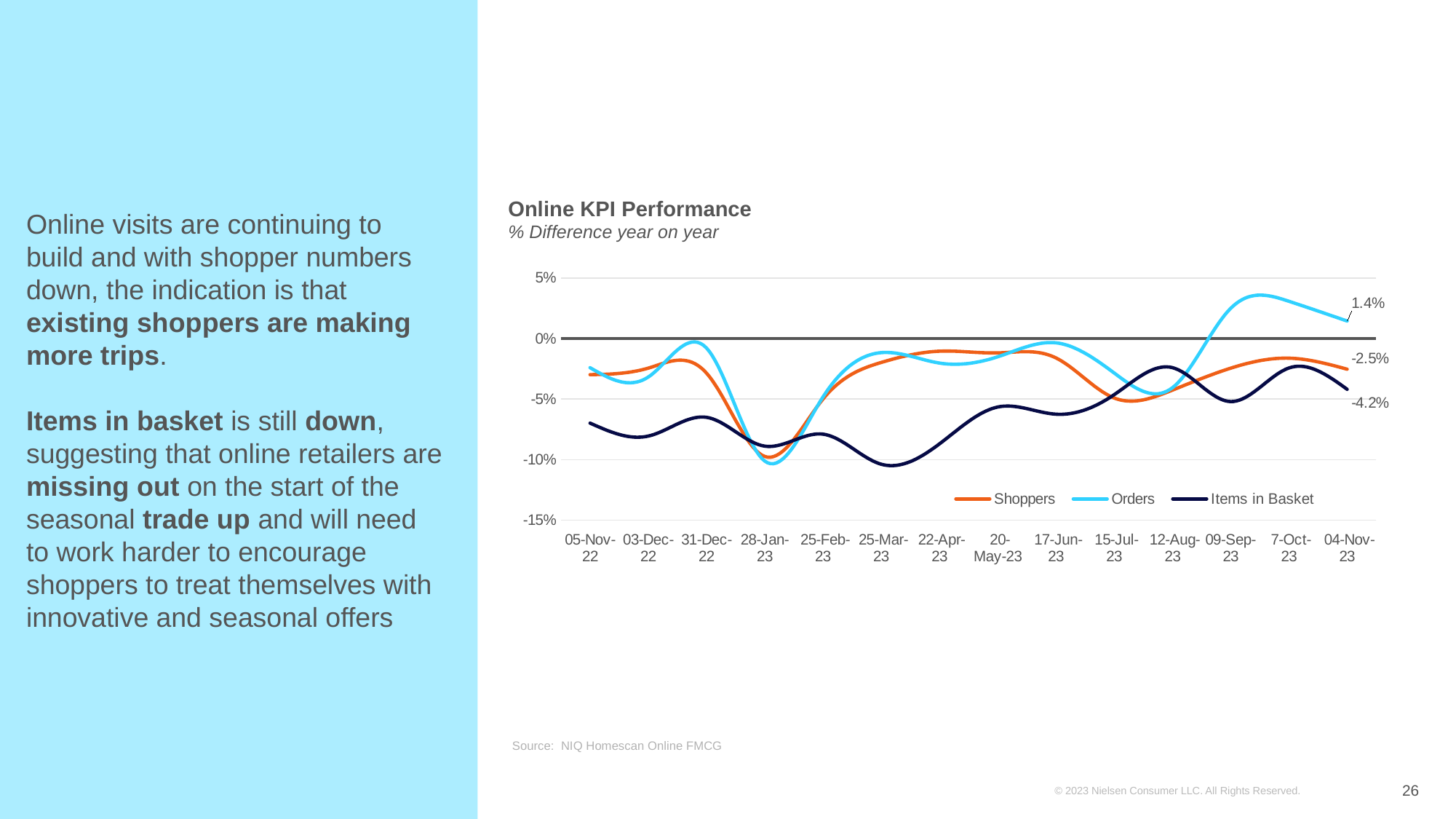
Is the value for Orders at 09-Sep-23 greater or less than 0%? greater How many series does the legend of the Online KPI Performance chart list? 3 Which series has the lowest value at 04-Nov-23? Items in Basket What is the value for Items in Basket at 04-Nov-23? -4.2% How many dates are shown on the x axis of the Online KPI Performance chart? 14 Which series has the highest value at 04-Nov-23? Orders What is the difference between the Orders value and the Items in Basket value at 04-Nov-23? 5.6 percentage points Is the value for Items in Basket at 05-Nov-22 greater or less than -5%? less What is the value for Shoppers at 04-Nov-23? -2.5% What is the subtitle of the Online KPI Performance chart? % Difference year on year What kind of chart is shown on the slide? Line chart What is the value for Orders at 04-Nov-23? 1.4%